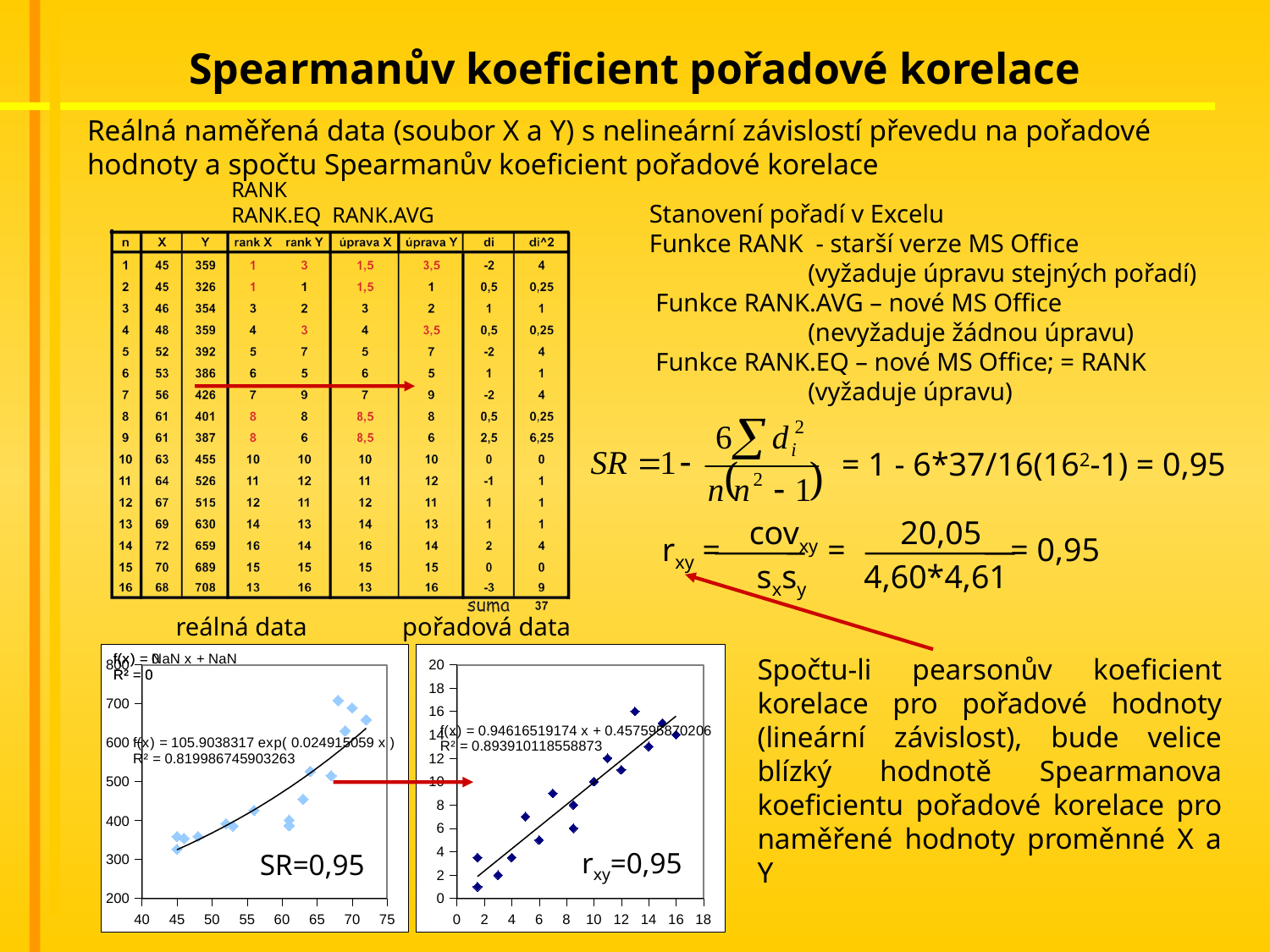
In the right chart 'pořadová data', do the plotted values generally rise or fall as x increases? rise How many data points are plotted in the left chart 'reálná data'? 16 In the right chart 'pořadová data', is the y value of the point at x = 2 greater or less than 10? less What kind of chart is the left chart labelled 'reálná data'? scatter chart What SR value is written inside the left chart 'reálná data'? SR=0,95 In the right chart 'pořadová data', is the y value of the point at x = 16 greater or less than 10? greater What kind of chart is the right chart labelled 'pořadová data'? scatter chart In the left chart 'reálná data', is the y value of the highest point greater or less than 600? greater How many data points are plotted in the right chart 'pořadová data'? 16 In the left chart 'reálná data', do the plotted values generally rise or fall as x increases? rise What r_xy value is written inside the right chart 'pořadová data'? r_xy=0,95